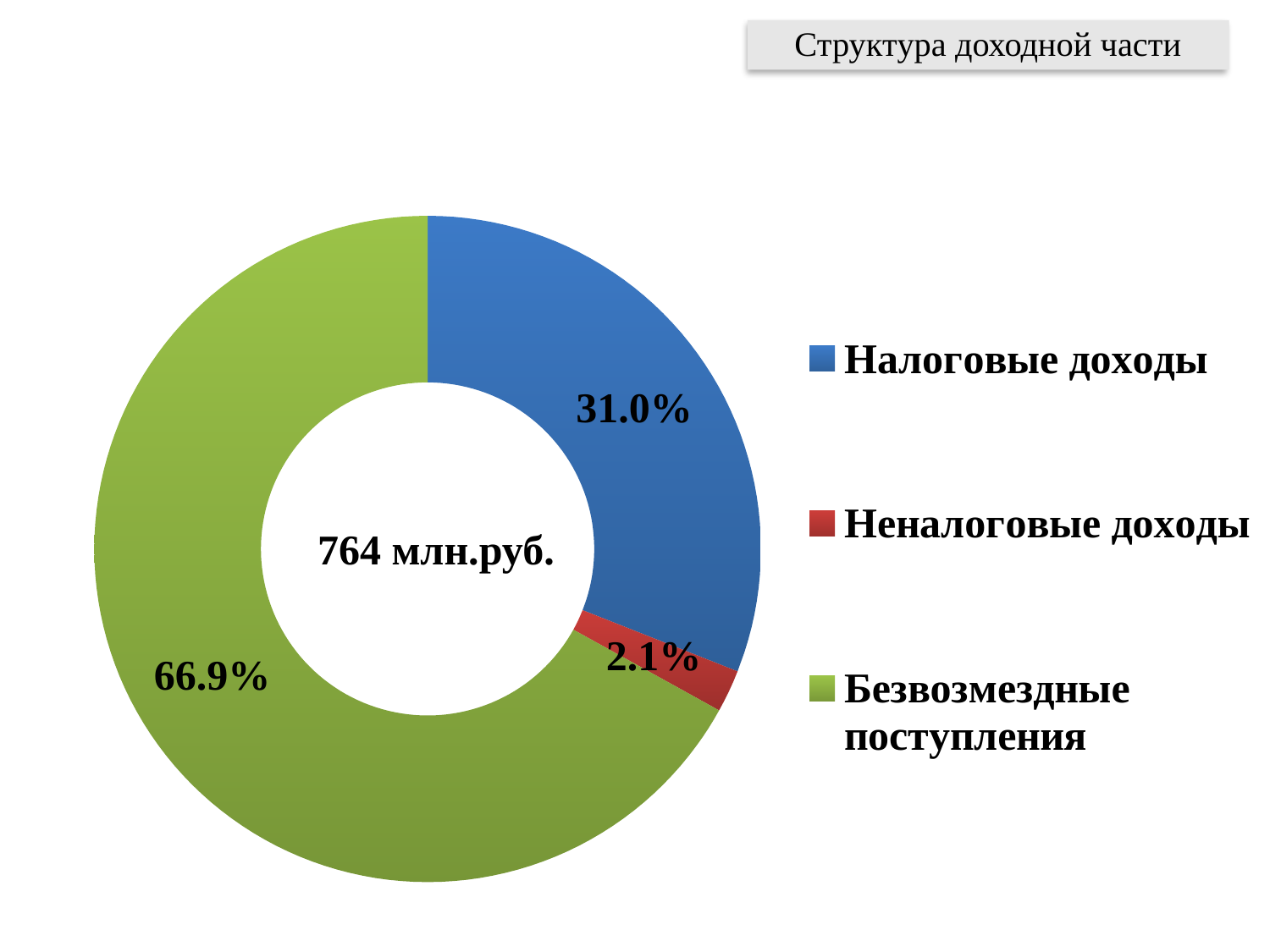
Which category has the largest share of the chart? Безвозмездные поступления Which category has the smallest share of the chart? Неналоговые доходы What kind of chart is shown on the slide? Pie chart (doughnut) What is the difference in percentage points between Безвозмездные поступления and Налоговые доходы? 35.9 How many categories are shown in the chart? 3 What share of the chart does Налоговые доходы represent? 31.0% What share of the chart does Безвозмездные поступления represent? 66.9% What is the title shown on the slide? Структура доходной части What is the difference in percentage points between Налоговые доходы and Неналоговые доходы? 28.9 What total value is printed in the centre of the chart? 764 млн.руб. What share of the chart does Неналоговые доходы represent? 2.1% Which is larger: the share for Налоговые доходы or the share for Неналоговые доходы? Налоговые доходы